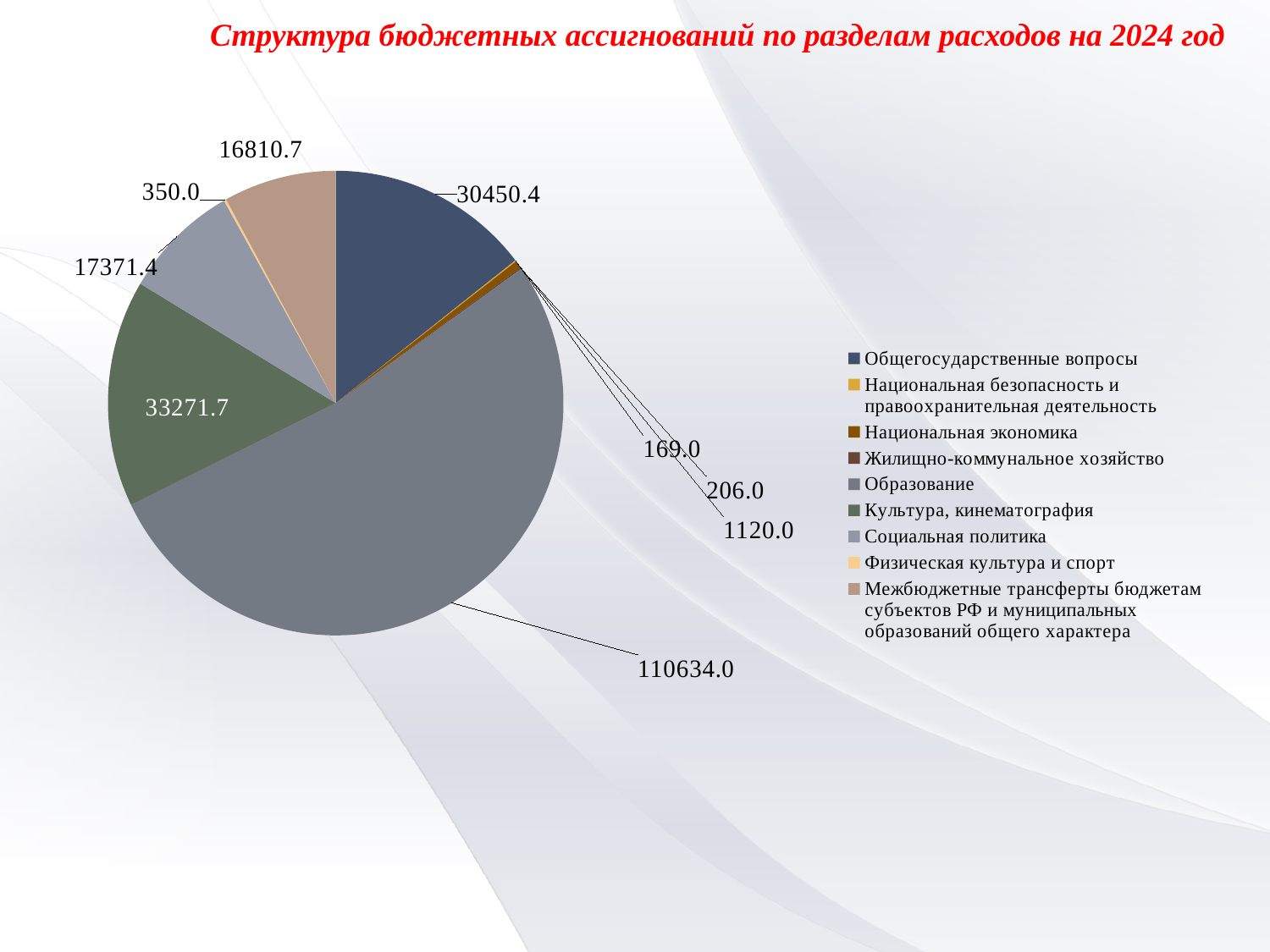
What is the value for Культура, кинематография? 33271.7 How many categories does the pie chart have? 9 Which category has the smallest value? Национальная безопасность и правоохранительная деятельность Which is larger: the value for Социальная политика or the value for Межбюджетные трансферты бюджетам субъектов РФ и муниципальных образований общего характера? Социальная политика What is the title of the chart? Структура бюджетных ассигнований по разделам расходов на 2024 год What is the value for Образование? 110634.0 What is the value for Общегосударственные вопросы? 30450.4 Which category has the largest slice of the pie? Образование What is the value for Социальная политика? 17371.4 What kind of chart is shown on the slide? Pie chart What is the value for Жилищно-коммунальное хозяйство? 206.0 What is the difference between the values for Культура, кинематография and Общегосударственные вопросы? 2821.3